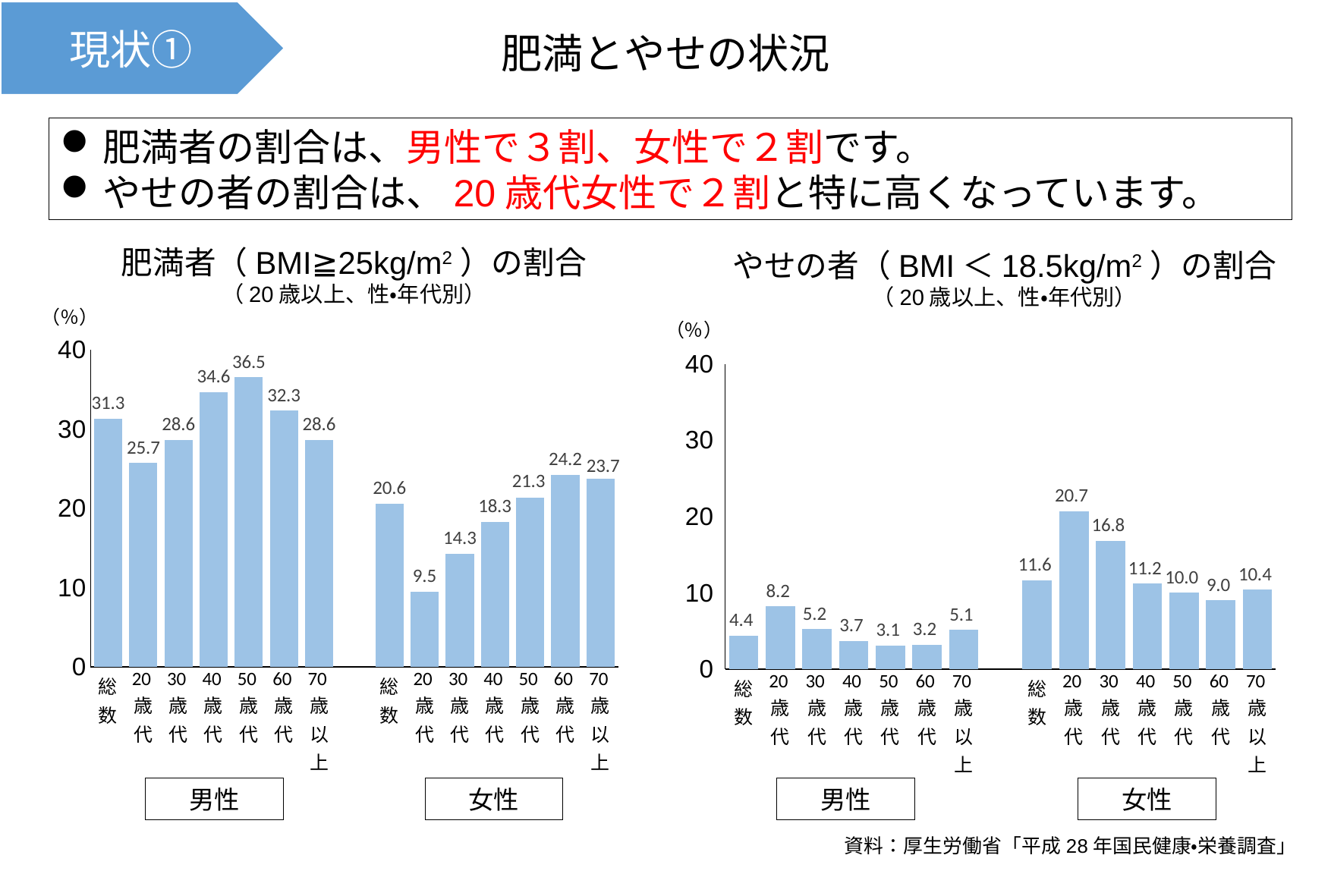
In the left chart (肥満者の割合), what is the value for 男性 50歳代? 36.5 What type of chart is the right chart (やせの者の割合)? Bar chart In the right chart (やせの者の割合), which is larger: 男性 20歳代 or 女性 60歳代? 女性 60歳代 In the left chart (肥満者の割合), which 女性 age group has the lowest value? 20歳代 In the right chart (やせの者の割合), what is the value for 男性 総数? 4.4 In the right chart (やせの者の割合), what is the value for 女性 20歳代? 20.7 In the left chart (肥満者の割合), what is the value for 女性 総数? 20.6 In the left chart (肥満者の割合), what is the difference between 男性 総数 and 女性 総数? 10.7 In the left chart (肥満者の割合), which 男性 age group has the highest value? 50歳代 In the right chart (やせの者の割合), what is the difference between 女性 20歳代 and 女性 30歳代? 3.9 How many bars are plotted in the left chart (肥満者の割合)? 14 In the right chart (やせの者の割合), which 男性 age group has the lowest value? 50歳代